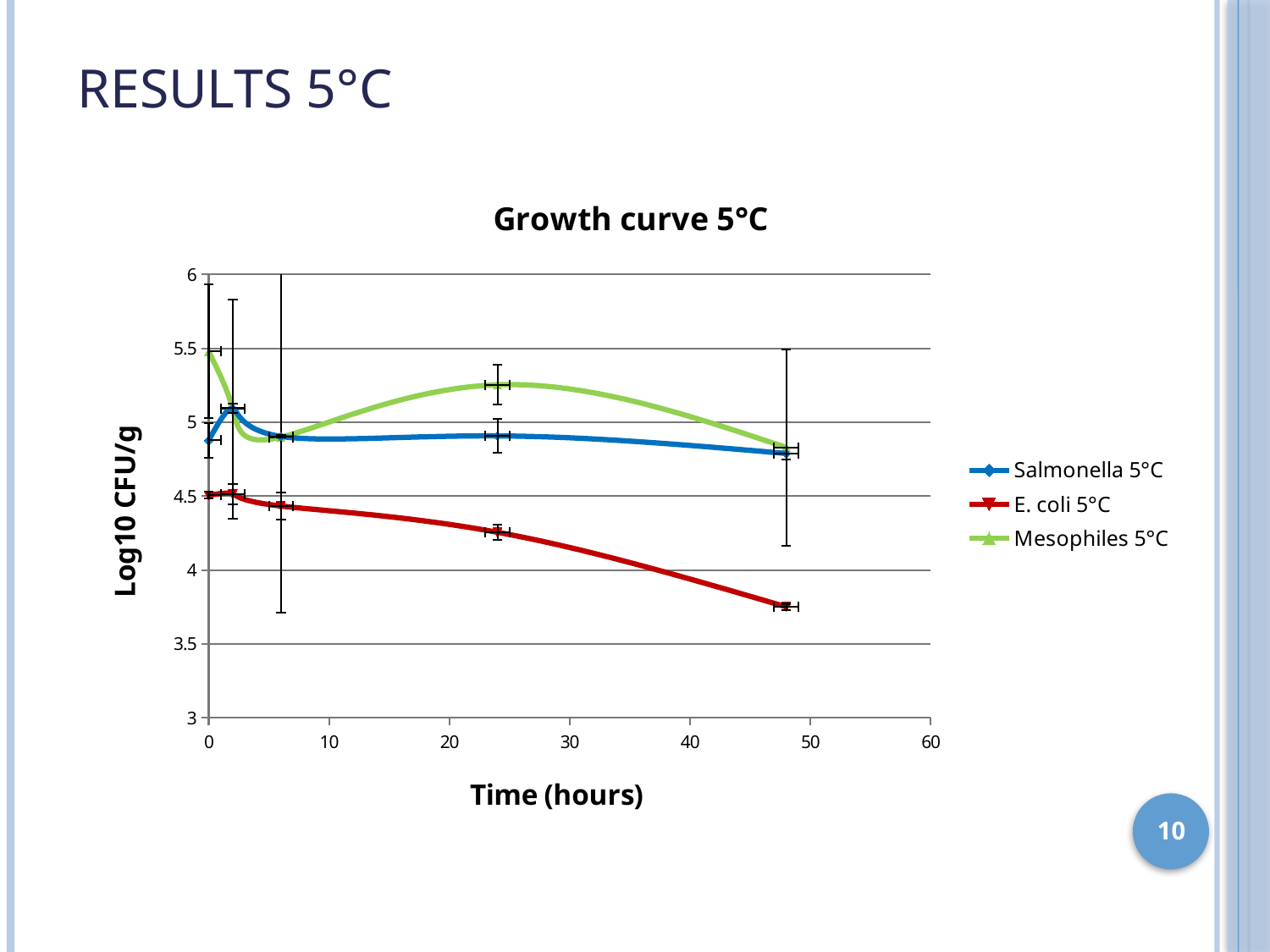
How many series does the legend of the Growth curve 5°C chart list? 3 Is the value for Mesophiles 5°C at 0 hours greater or less than 5? greater What is the title of the chart? Growth curve 5°C Is the value for Mesophiles 5°C at 24 hours greater or less than 5? greater Is the value for E. coli 5°C at 48 hours greater or less than 4? less Which series has the highest value at 24 hours? Mesophiles 5°C At 48 hours, which is larger: the value for Salmonella 5°C or the value for E. coli 5°C? Salmonella 5°C Do the values for E. coli 5°C rise or fall as time increases from 0 to 48 hours? fall What is the label of the y axis of the chart? Log10 CFU/g What kind of chart is shown on the slide? line chart Which series has the lowest value at 24 hours? E. coli 5°C